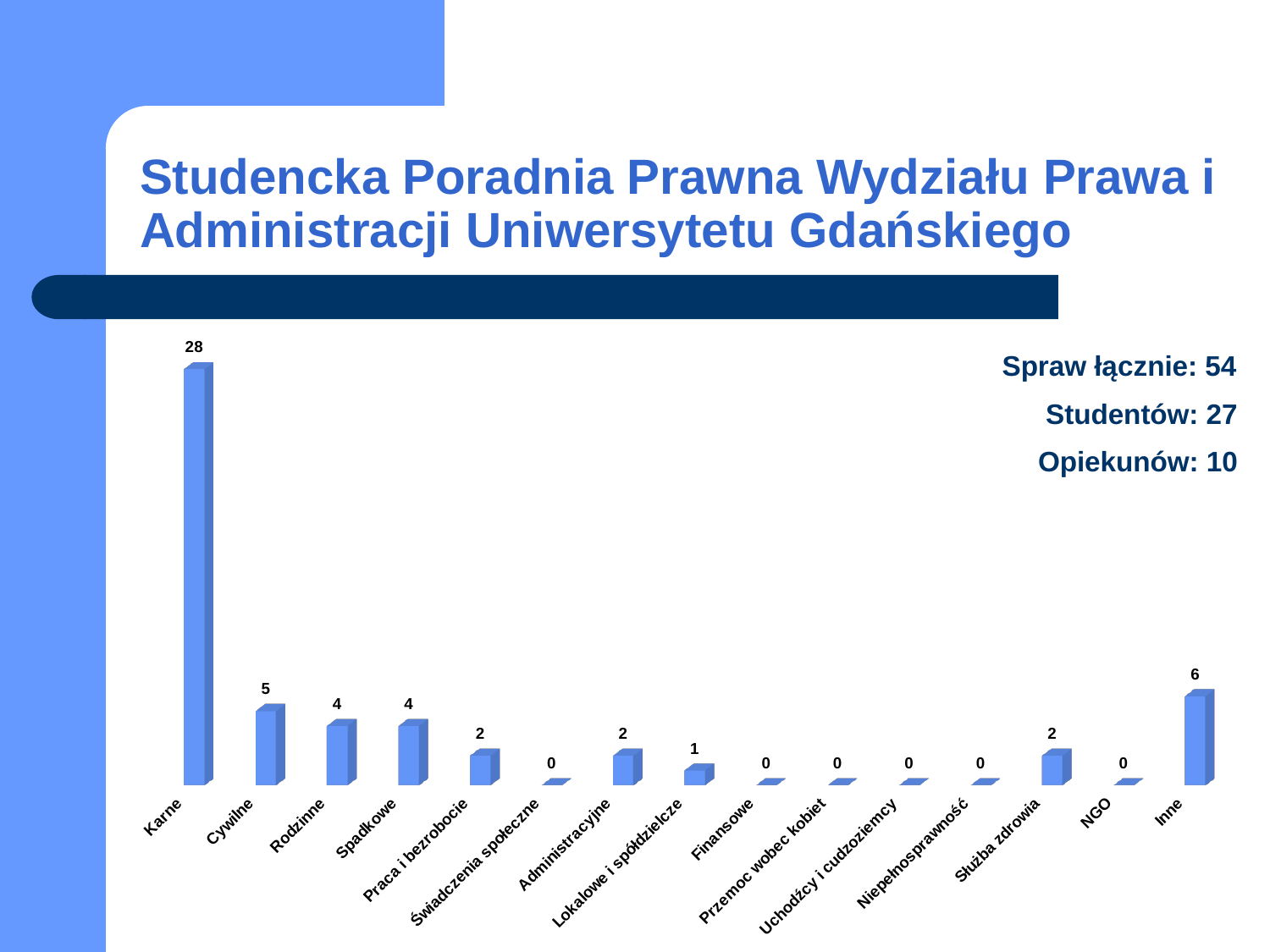
What is the difference between the values for Karne and Inne? 22 Which category has the highest value? Karne What is the value for Inne? 6 What is the value for Służba zdrowia? 2 What is the value for Cywilne? 5 According to the text on the slide, what is the total number of cases (Spraw łącznie)? 54 What is the value for Karne? 28 Which is larger, the value for Inne or the value for Cywilne? Inne How many categories are shown on the x axis? 15 What is the difference between the values for Cywilne and Rodzinne? 1 What kind of chart is shown on the slide? bar chart What is the value for Lokalowe i spółdzielcze? 1